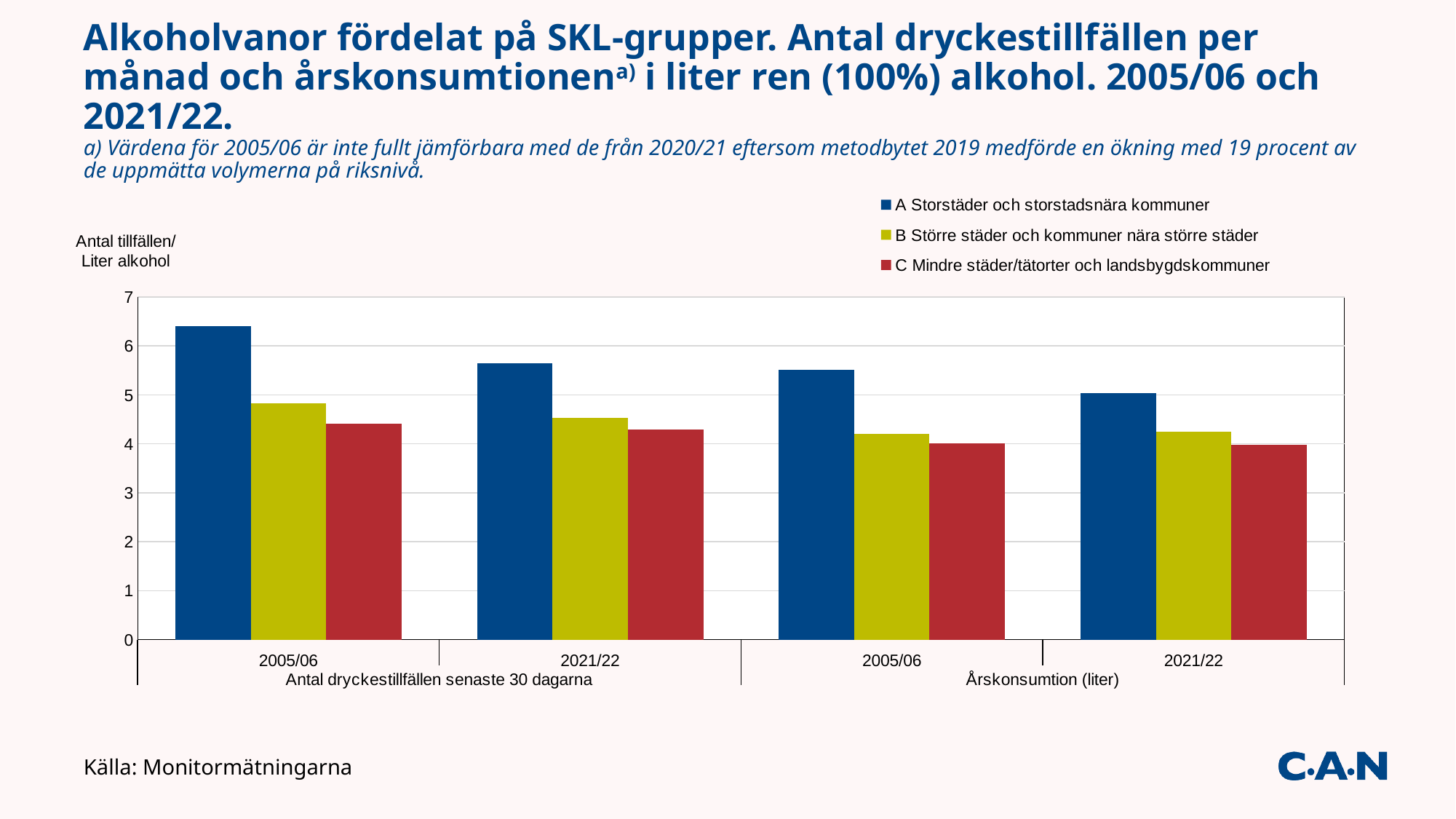
Is the value for A Storstäder och storstadsnära kommuner in 2005/06 for Antal dryckestillfällen senaste 30 dagarna greater or less than 6? greater Is the value for C Mindre städer/tätorter och landsbygdskommuner in 2021/22 for Årskonsumtion (liter) greater or less than 5? less What kind of chart is shown on the slide? Bar chart How many series does the legend list? 3 What colour are the bars for C Mindre städer/tätorter och landsbygdskommuner? Red For A Storstäder och storstadsnära kommuner, which is larger for Antal dryckestillfällen senaste 30 dagarna: 2005/06 or 2021/22? 2005/06 Does the value for A Storstäder och storstadsnära kommuner rise or fall from 2005/06 to 2021/22 for Årskonsumtion (liter)? Fall Is the value for B Större städer och kommuner nära större städer in 2005/06 for Antal dryckestillfällen senaste 30 dagarna greater or less than 5? less Which series has the highest bar in the 2005/06 group for Antal dryckestillfällen senaste 30 dagarna? A Storstäder och storstadsnära kommuner How many category groups are plotted along the x axis? 4 Which series has the lowest bar in the 2005/06 group for Antal dryckestillfällen senaste 30 dagarna? C Mindre städer/tätorter och landsbygdskommuner